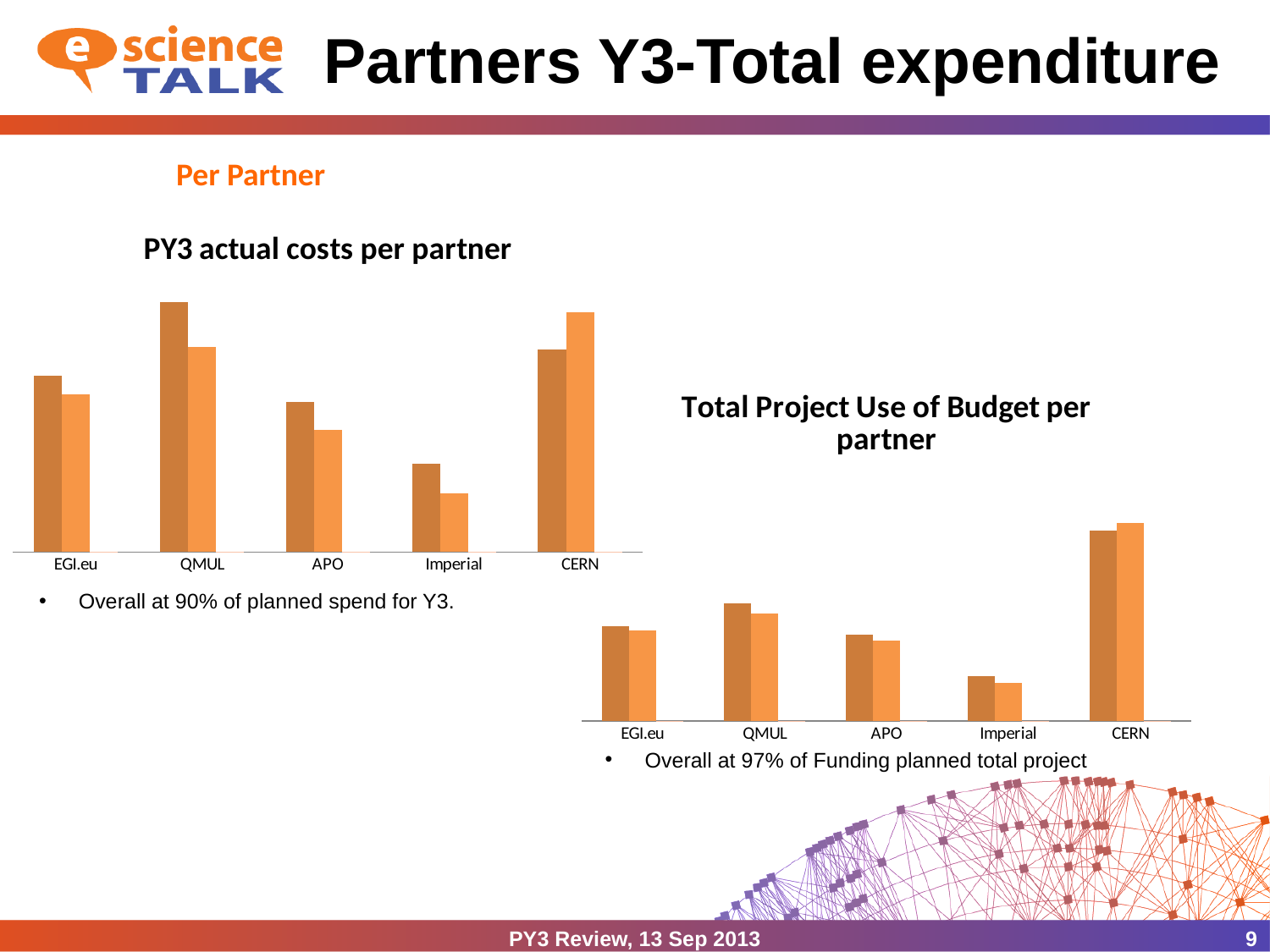
In the 'PY3 actual costs per partner' chart, is the dark orange bar for EGI.eu taller or shorter than the dark orange bar for APO? taller What kind of chart is the 'Total Project Use of Budget per partner' chart? bar chart In the 'PY3 actual costs per partner' chart, which partner has the tallest dark orange bar? QMUL How many partners are shown on the x axis of the 'PY3 actual costs per partner' chart? 5 What is the title of the chart on the right side of the slide? Total Project Use of Budget per partner In the 'Total Project Use of Budget per partner' chart, which partner has the lowest bars? Imperial In the 'PY3 actual costs per partner' chart, which partner has the lowest bars? Imperial In the 'PY3 actual costs per partner' chart, for CERN, is the light orange bar taller or shorter than the dark orange bar? taller How many partners are shown on the x axis of the 'Total Project Use of Budget per partner' chart? 5 In the 'Total Project Use of Budget per partner' chart, which partner has the highest bars? CERN In the 'Total Project Use of Budget per partner' chart, which has taller bars, QMUL or APO? QMUL What kind of chart is the 'PY3 actual costs per partner' chart? bar chart